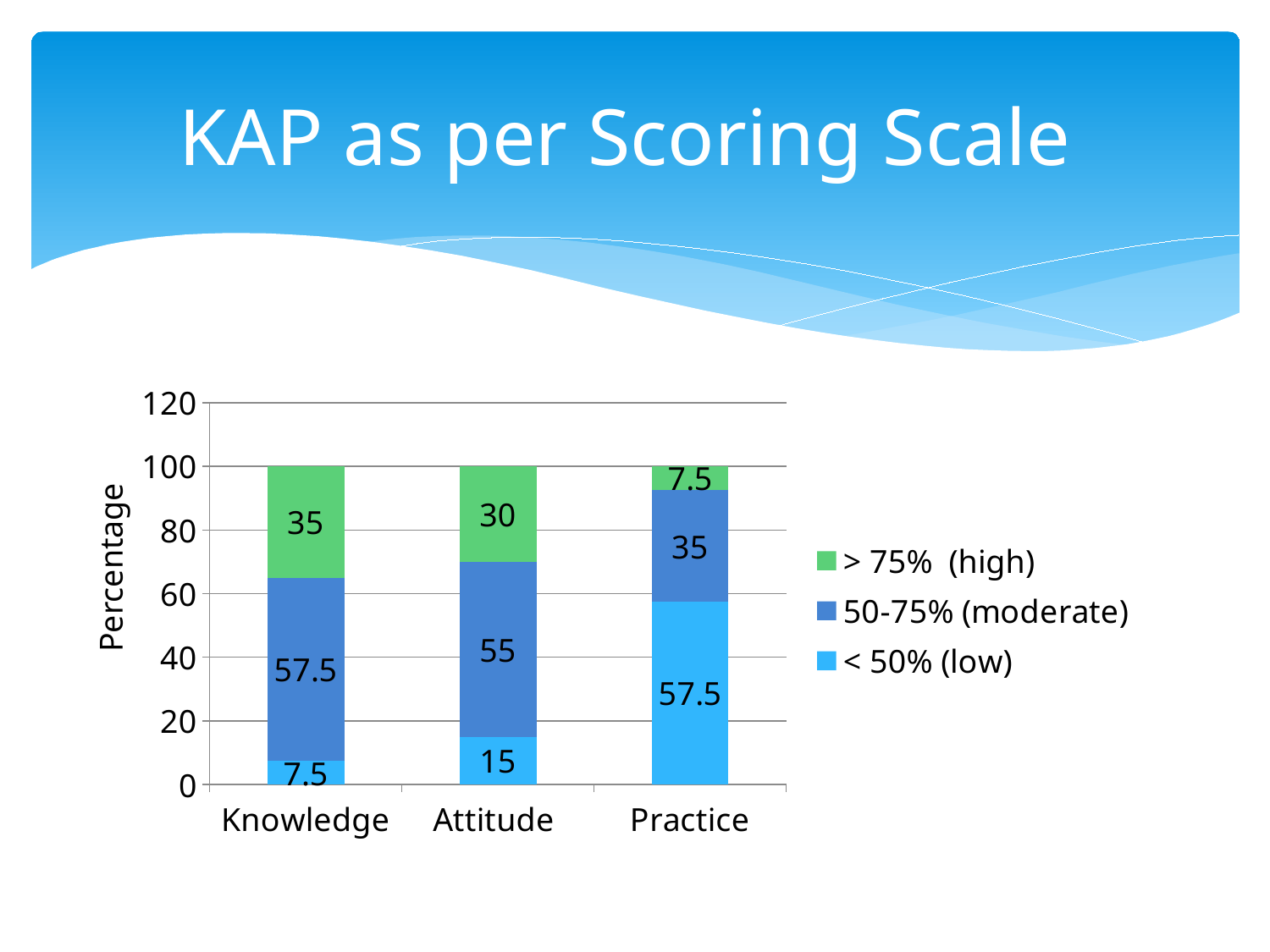
How many categories are shown on the x axis? 3 Which category has the highest '> 75% (high)' value? Knowledge What is the value of the '> 75% (high)' segment for Practice? 7.5 What is the value of the '50-75% (moderate)' segment for Attitude? 55 How many series does the legend list? 3 What is the difference between the '50-75% (moderate)' values for Knowledge and Practice? 22.5 What is the total of the stacked bar for Attitude? 100 What kind of chart is shown on the slide? Stacked bar chart Which is larger: the '> 75% (high)' value for Attitude or for Practice? Attitude What is the value of the '< 50% (low)' segment for Knowledge? 7.5 What is the value of the '< 50% (low)' segment for Practice? 57.5 Which category has the lowest '< 50% (low)' value? Knowledge